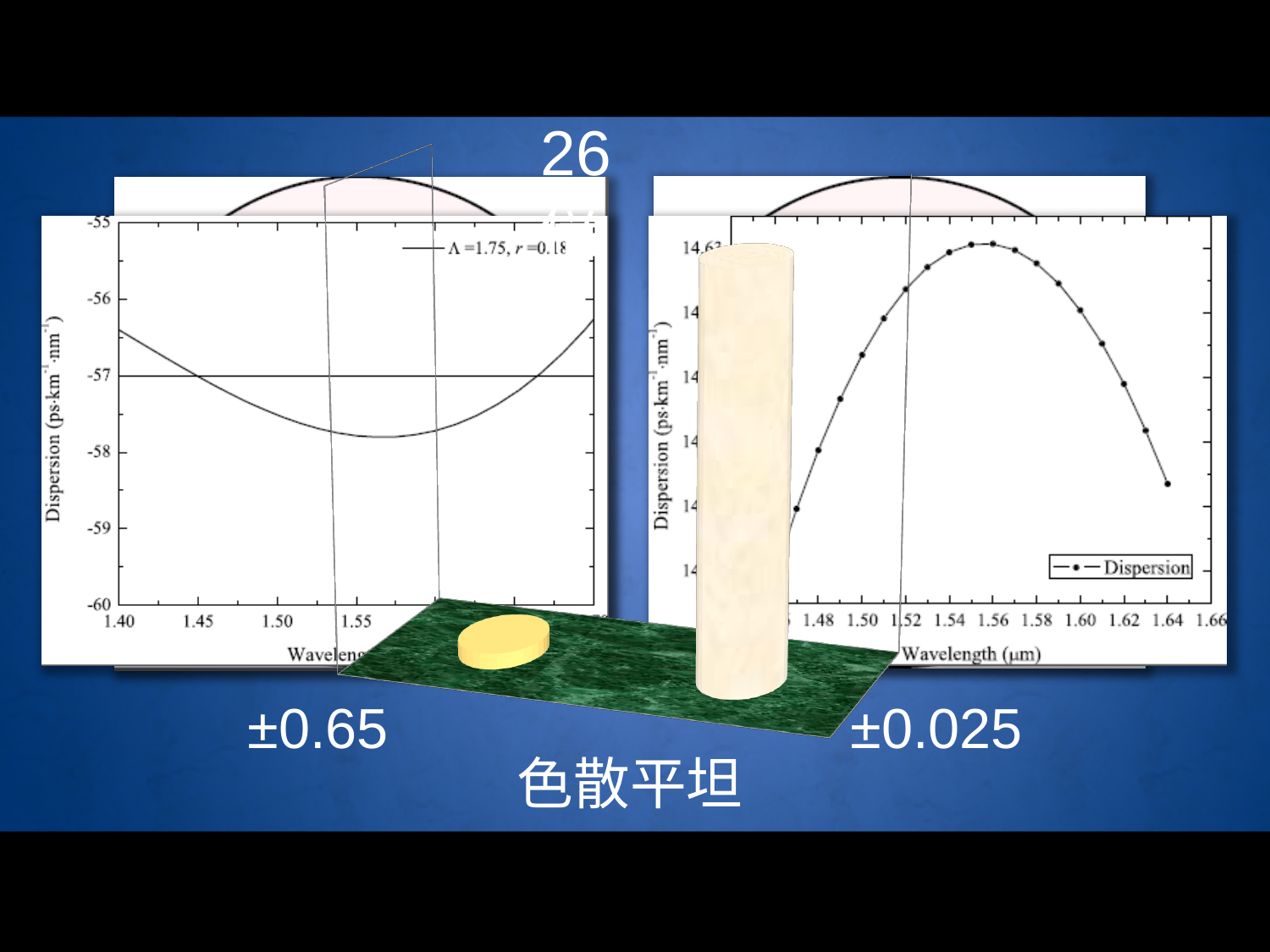
In the left chart, is the dispersion value at wavelength 1.50 greater or less than -58? greater In the left chart, is the dispersion value at wavelength 1.40 greater or less than -57? greater In the left chart, does the dispersion curve fall or rise as the wavelength goes from 1.40 to 1.50? fall What is the legend entry shown in the left chart? Λ=1.75, r=0.18 What kind of chart is the right chart (with legend 'Dispersion')? line chart How many series does the legend of the left chart list? 1 What kind of chart is the left chart (with legend Λ=1.75, r=0.18)? line chart In the left chart, is the dispersion value at wavelength 1.55 greater or less than -57? less In the right chart, does the dispersion curve rise or fall as the wavelength goes from 1.58 to 1.64? fall In the right chart, does the dispersion curve rise or fall as the wavelength goes from 1.48 to 1.54? rise What is the x-axis label of the right chart? Wavelength (μm) How many series does the legend of the right chart list? 1